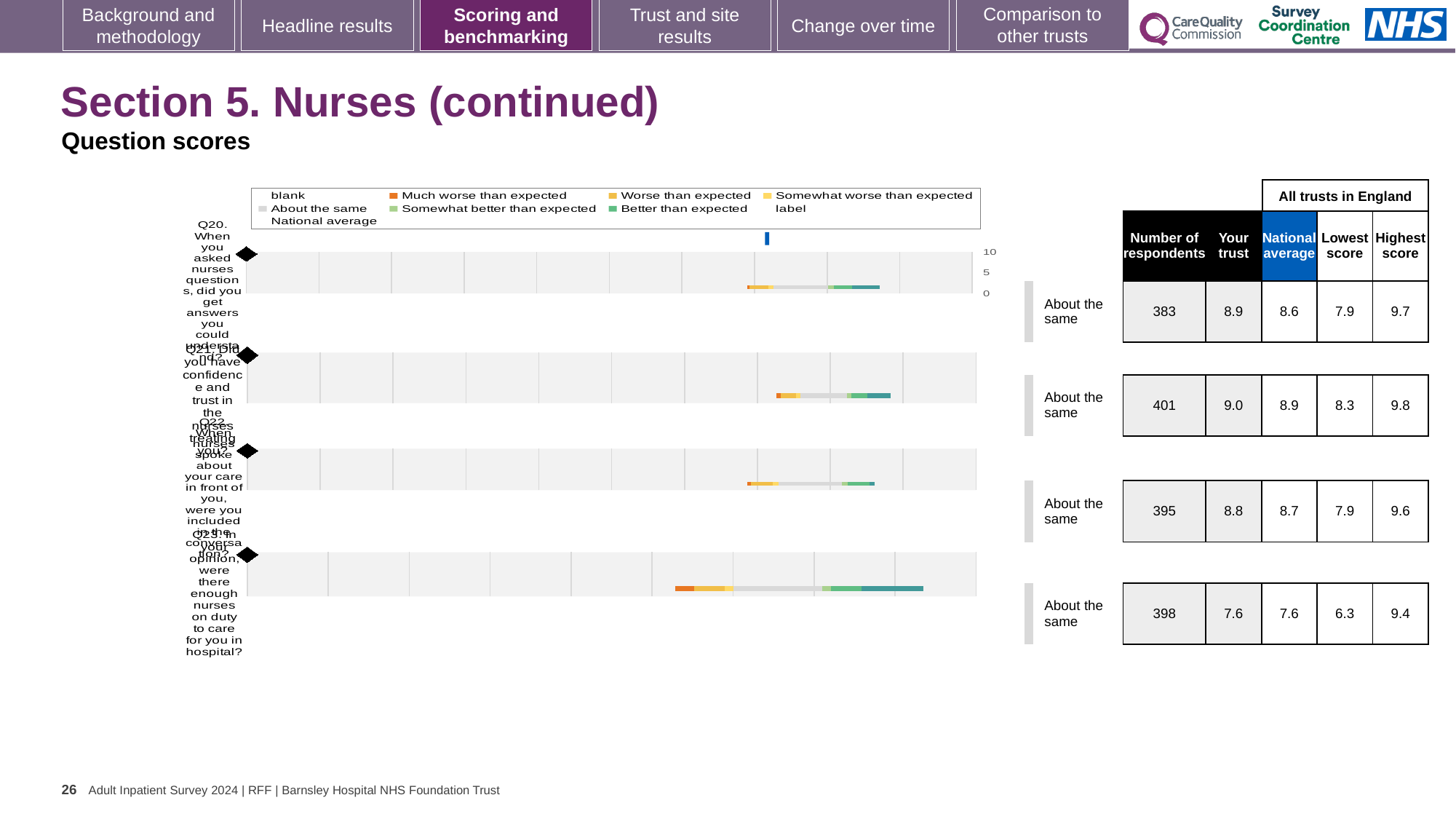
How many questions (rows) are plotted in the question scores chart? 4 What benchmark category is shown next to each of the four question charts? About the same Which question has the highest 'Your trust' score? Q21 Is the 'Your trust' score for Q23 greater or less than 5? greater What kind of chart is used to show the question scores for Q20 to Q23? bar chart How many respondents answered Q22? 395 What is the national average score for Q23 (enough nurses on duty)? 7.6 For Q20, what is the difference between the 'Your trust' score and the national average? 0.3 Which question has the lowest 'Your trust' score? Q23 What is the 'Your trust' score for Q21 (confidence and trust in the nurses)? 9.0 For Q22, which is larger: the 'Your trust' score or the national average? Your trust For Q21, what is the difference between the highest score and the lowest score across all trusts in England? 1.5